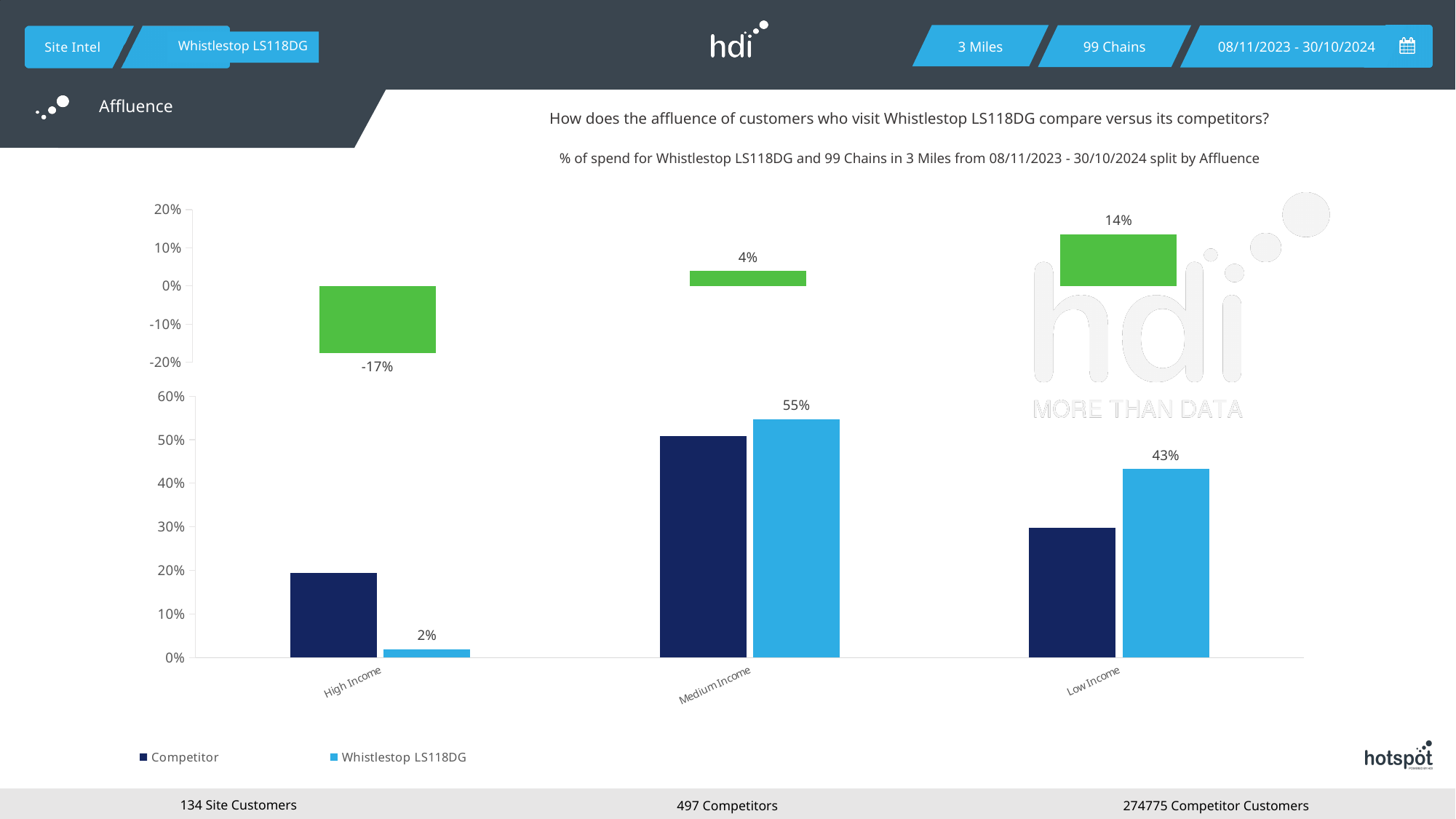
In the bottom chart, what is the % of spend for Whistlestop LS118DG in the Low Income category? 43% In the top chart (green bars), which category has the lowest value? High Income In the top chart (green bars), what is the value shown for Low Income? 14% In the bottom chart, which category has the highest Whistlestop LS118DG value? Medium Income In the bottom chart, which is larger for High Income: the Competitor value or the Whistlestop LS118DG value? Competitor In the bottom chart, is the Competitor value for Low Income greater or less than 40%? less How many series does the legend of the bottom chart list? 2 In the bottom chart, what is the difference between the Whistlestop LS118DG values for Medium Income and Low Income? 12% In the bottom chart, what is the % of spend for Whistlestop LS118DG in the Medium Income category? 55% In the top chart (green bars), what is the value shown for High Income? -17% In the bottom chart, is the Competitor value for High Income greater or less than 10%? greater In the bottom chart, what is the % of spend for Whistlestop LS118DG in the High Income category? 2%